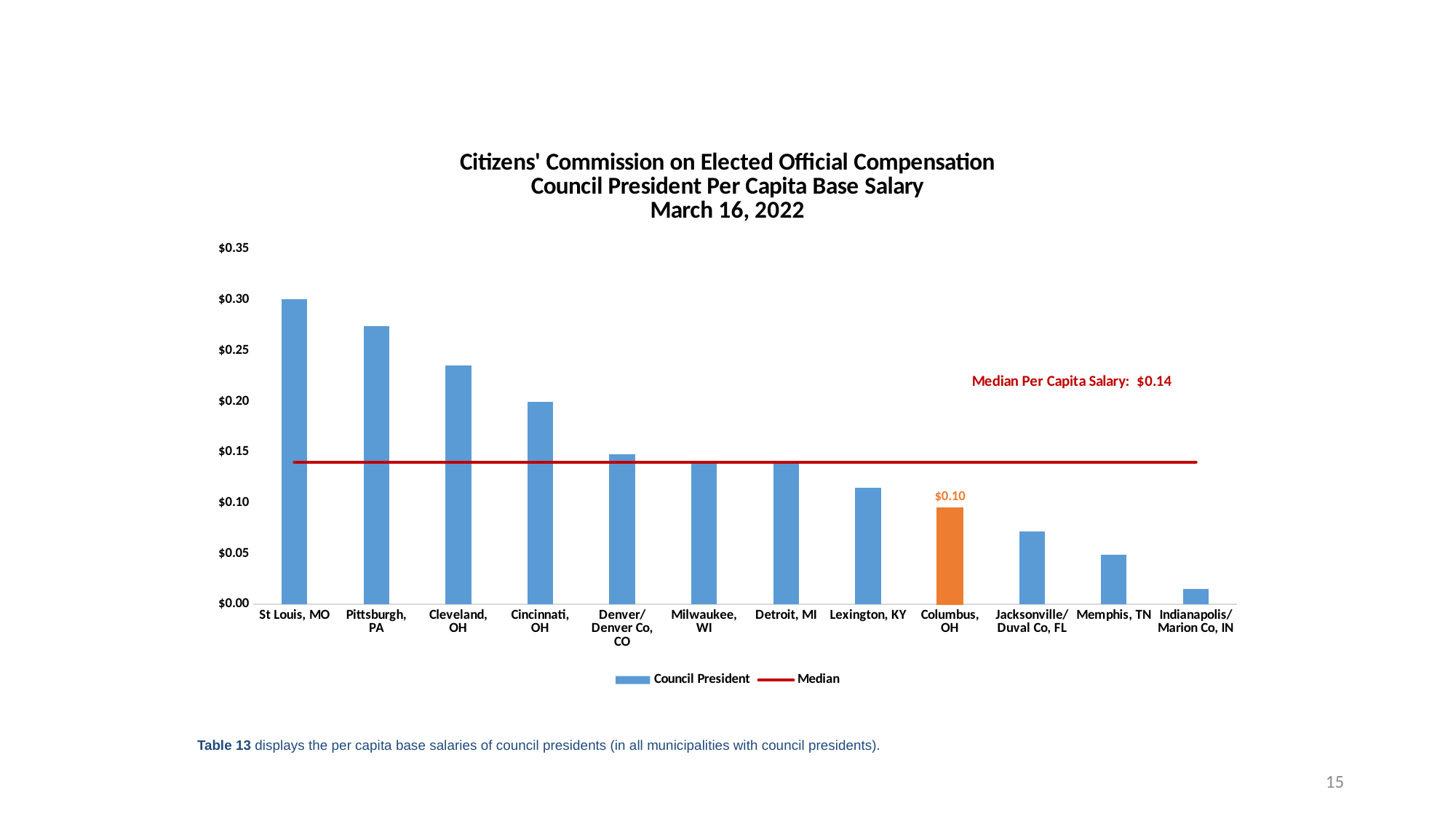
Is the value for Cleveland, OH greater or less than $0.20? greater Which municipality has the highest council president per capita base salary? St Louis, MO How many series does the chart legend list? 2 Do the bar values rise or fall moving from left to right along the x axis? fall Which has the larger per capita base salary, Pittsburgh, PA or Cleveland, OH? Pittsburgh, PA What kind of chart is shown on the slide? bar chart Is the value for Jacksonville/Duval Co, FL greater or less than $0.10? less How many municipalities are shown on the x axis of the chart? 12 What is the council president per capita base salary for Columbus, OH? $0.10 What is the median per capita salary shown on the chart? $0.14 Which municipality has the lowest council president per capita base salary? Indianapolis/Marion Co, IN Which has the larger per capita base salary, Detroit, MI or Lexington, KY? Detroit, MI